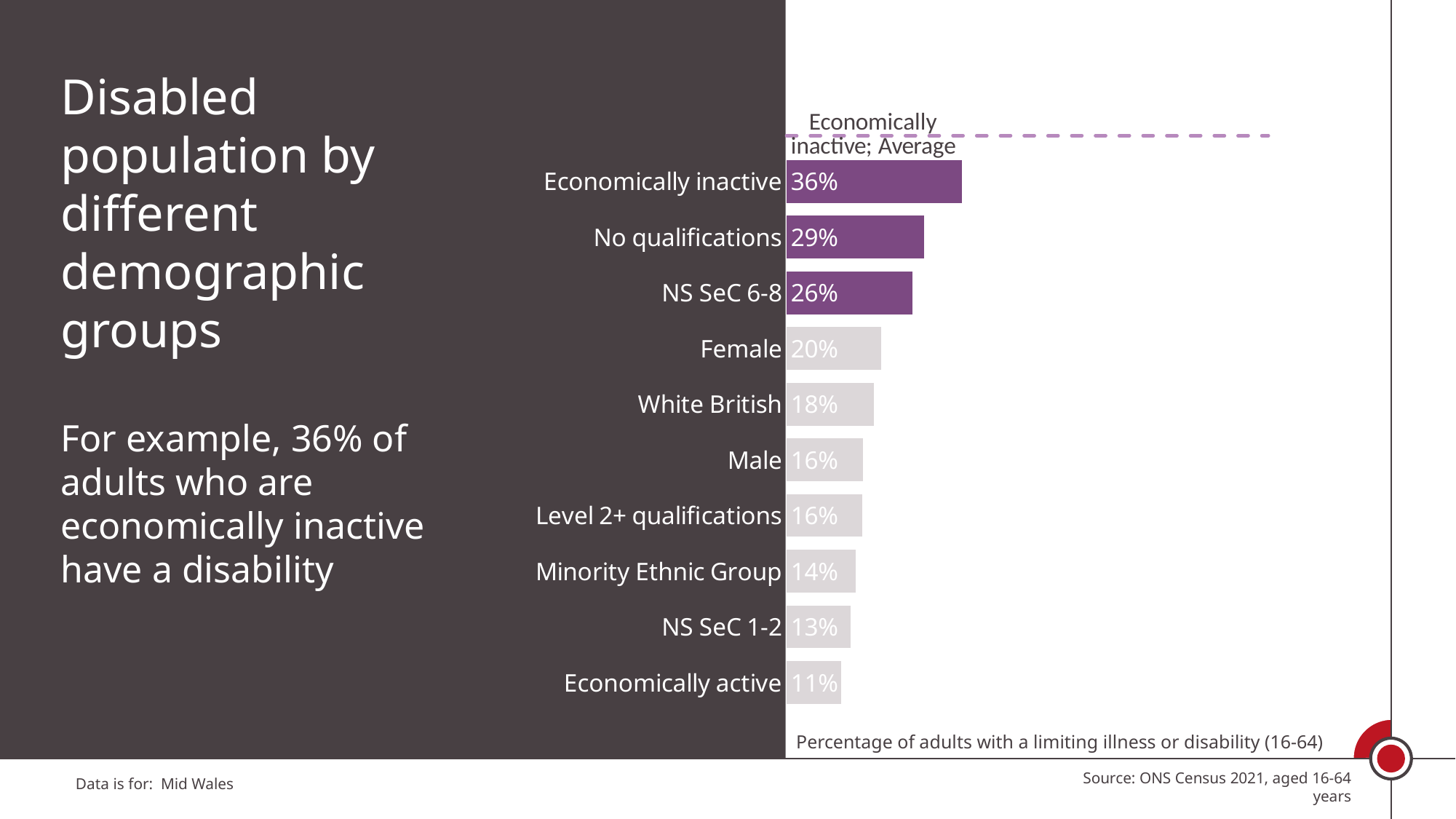
What is the difference between the 'Female' and 'Male' values? 4 percentage points What does the dashed line at the top of the chart represent? Economically inactive; Average What type of chart is shown on the slide? Bar chart Which has a higher value, 'White British' or 'Minority Ethnic Group'? White British What is the value shown for 'NS SeC 6-8'? 26% What is the difference in percentage points between the 'Economically inactive' and 'Economically active' groups? 25 percentage points Which demographic group has the lowest percentage of adults with a limiting illness or disability? Economically active How many demographic groups are shown in the chart? 10 What is the value shown for 'Minority Ethnic Group'? 14% What percentage of economically inactive adults have a limiting illness or disability? 36% What is the value shown for the 'No qualifications' group? 29% Which demographic group has the highest percentage of adults with a limiting illness or disability? Economically inactive